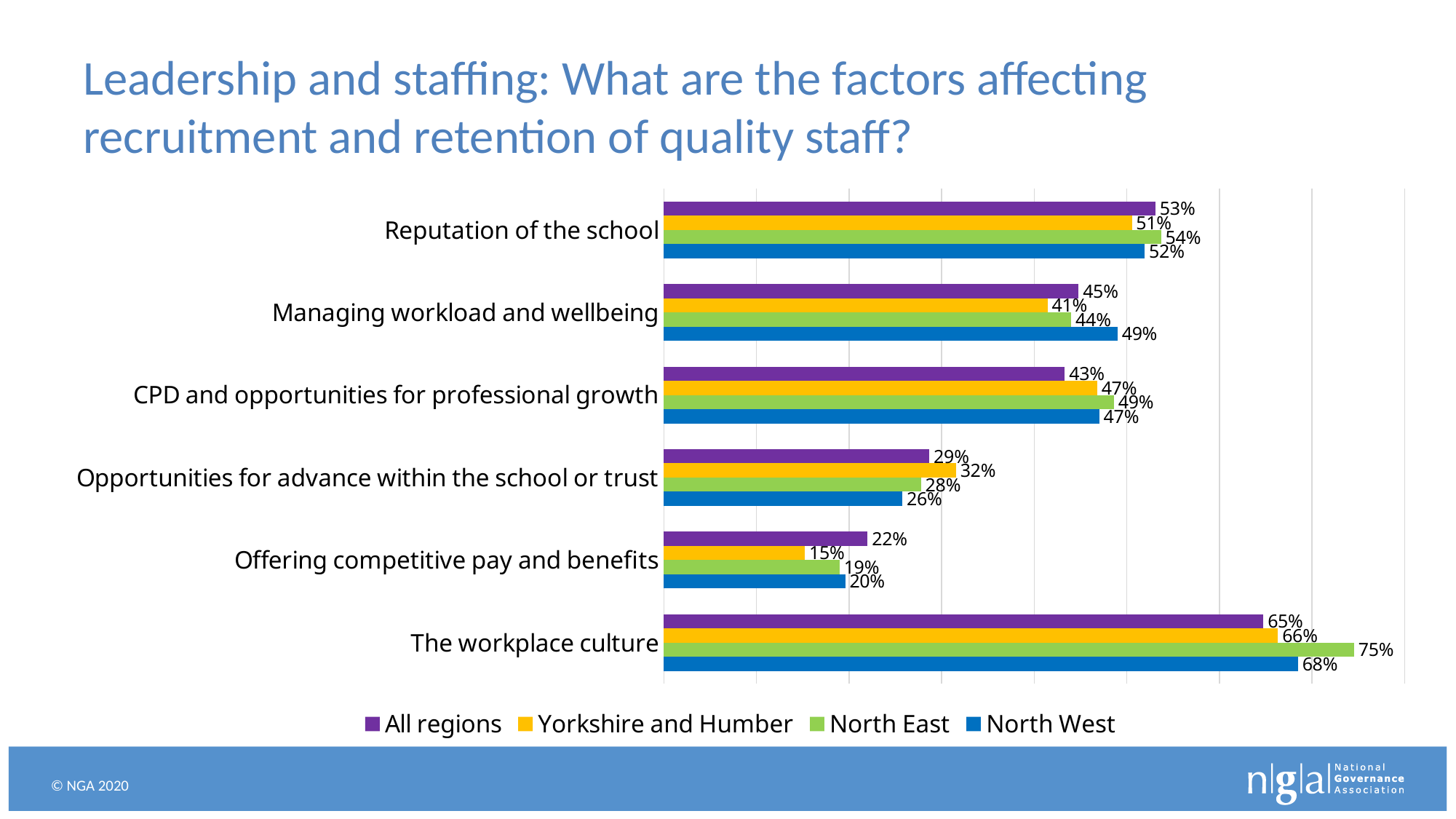
Which category has the lowest value for North West? Offering competitive pay and benefits What is the value for All regions for 'Reputation of the school'? 53% What is the value for North East for 'The workplace culture'? 75% How many series does the legend list? 4 What is the difference between the North East and All regions values for 'The workplace culture'? 10% For 'Opportunities for advance within the school or trust', which is larger: Yorkshire and Humber or North West? Yorkshire and Humber How many categories are shown on the chart? 6 Which category has the highest value for All regions? The workplace culture What is the value for North West for 'Managing workload and wellbeing'? 49% What is the value for Yorkshire and Humber for 'Offering competitive pay and benefits'? 15% Which colour represents North East in the legend? Green What kind of chart is shown on the slide? Bar chart